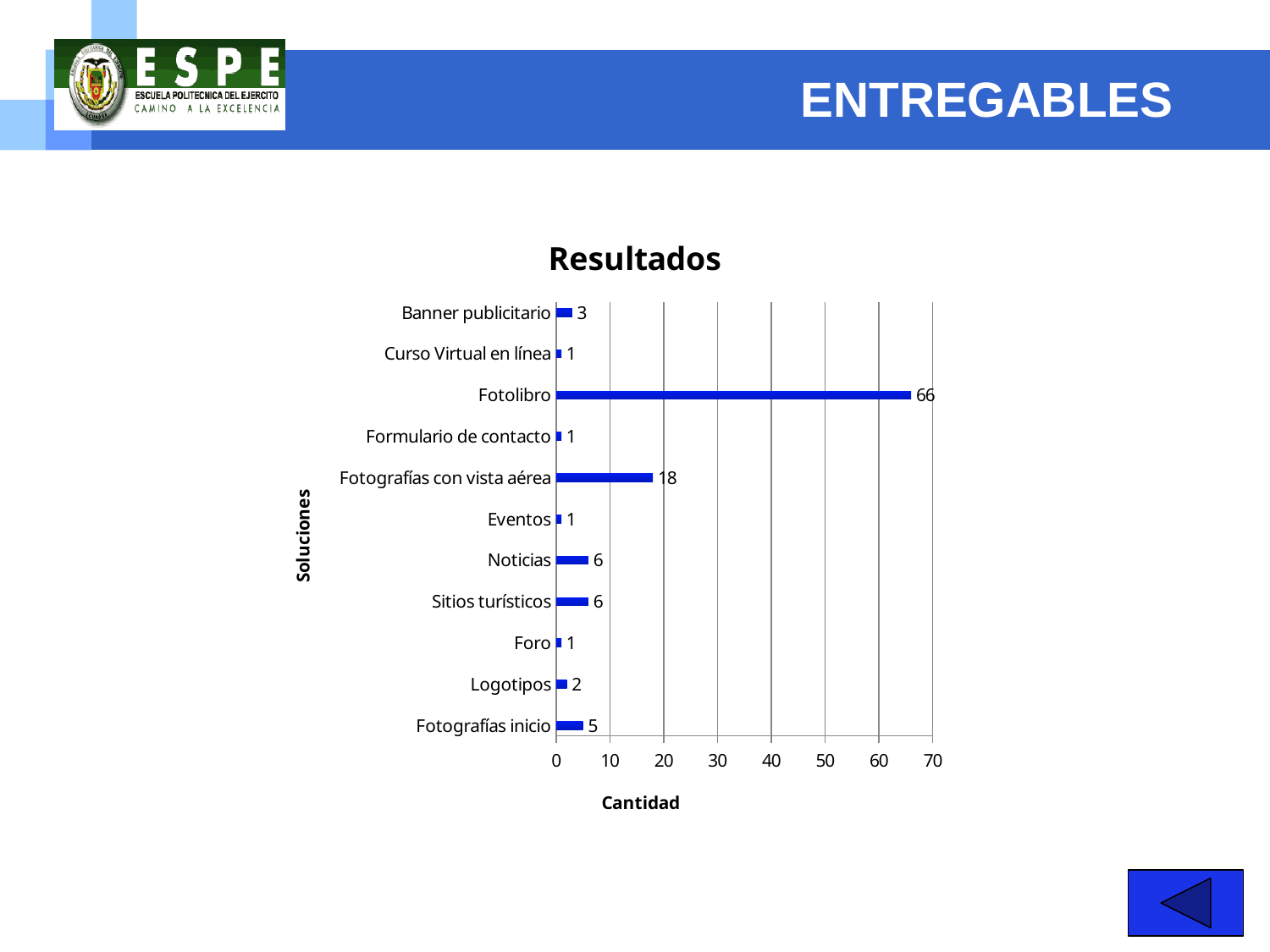
How many categories are shown on the chart? 11 What is the label of the horizontal axis? Cantidad Is the value for Fotolibro greater or less than 60? greater What is the value for Fotografías con vista aérea? 18 What is the title of the chart? Resultados What is the difference between the values for Fotolibro and Fotografías con vista aérea? 48 What kind of chart is shown? bar chart Which is larger, the value for Noticias or the value for Logotipos? Noticias What is the value for Banner publicitario? 3 What is the value for Fotolibro? 66 What is the value for Fotografías inicio? 5 Which category has the highest value? Fotolibro